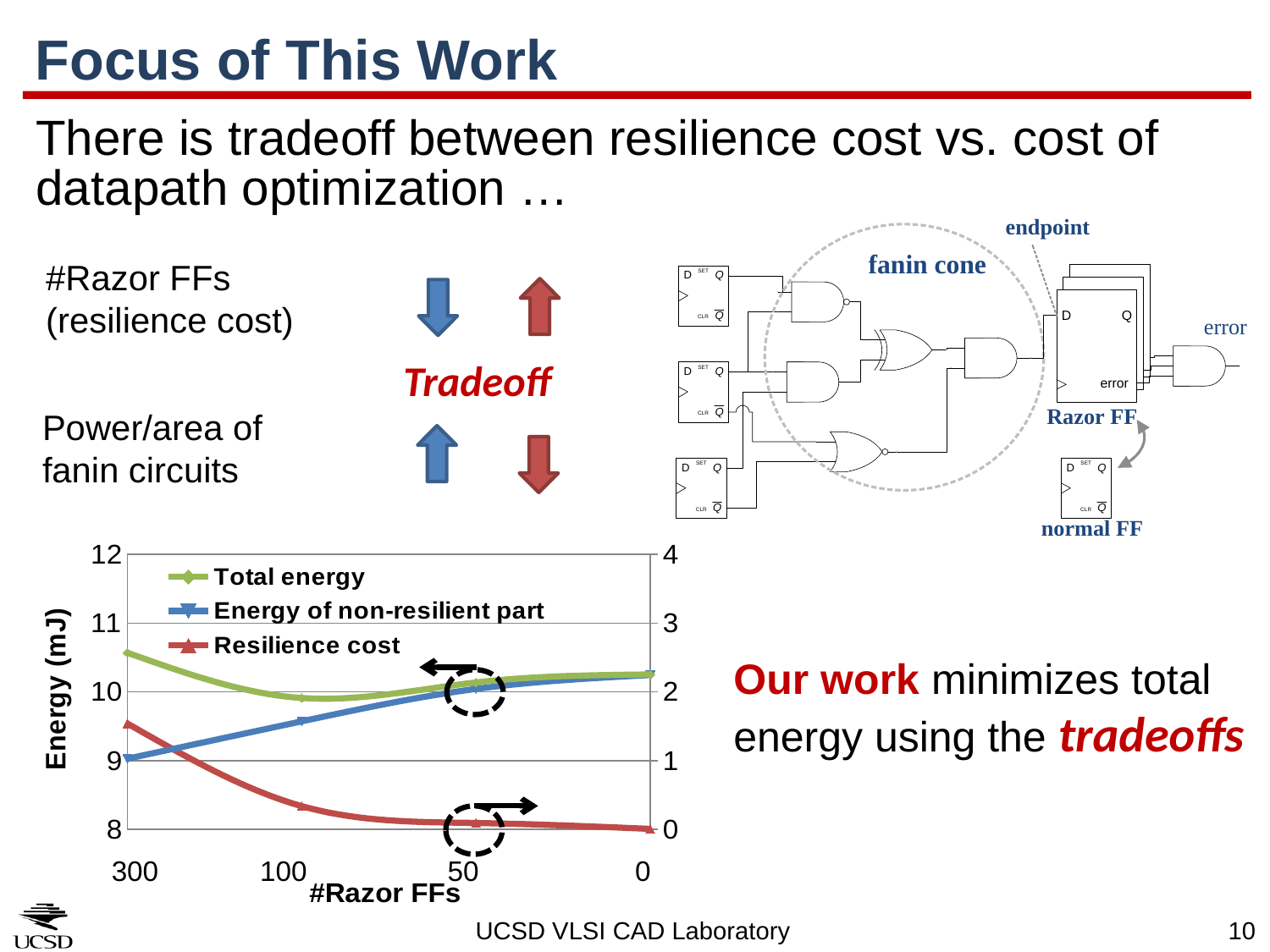
At which #Razor FFs value on the x axis is Total energy lowest? 100 What are the three series named in the chart's legend? Total energy, Energy of non-resilient part, Resilience cost Is the Total energy value at 300 Razor FFs greater or less than 10 mJ? greater Is the Total energy value at 100 Razor FFs greater or less than 11 mJ? less Moving from left to right along the x axis (from 300 to 0 Razor FFs), does the Energy of non-resilient part rise or fall? rise At 300 Razor FFs, which is larger: Total energy or Energy of non-resilient part? Total energy Is the Energy of non-resilient part at 100 Razor FFs greater or less than 10 mJ? less How many series does the chart's legend list? 3 What kind of chart is shown on the slide? line chart What is the title of the chart's x axis? #Razor FFs Moving from left to right along the x axis (from 300 to 0 Razor FFs), does the Resilience cost rise or fall? fall